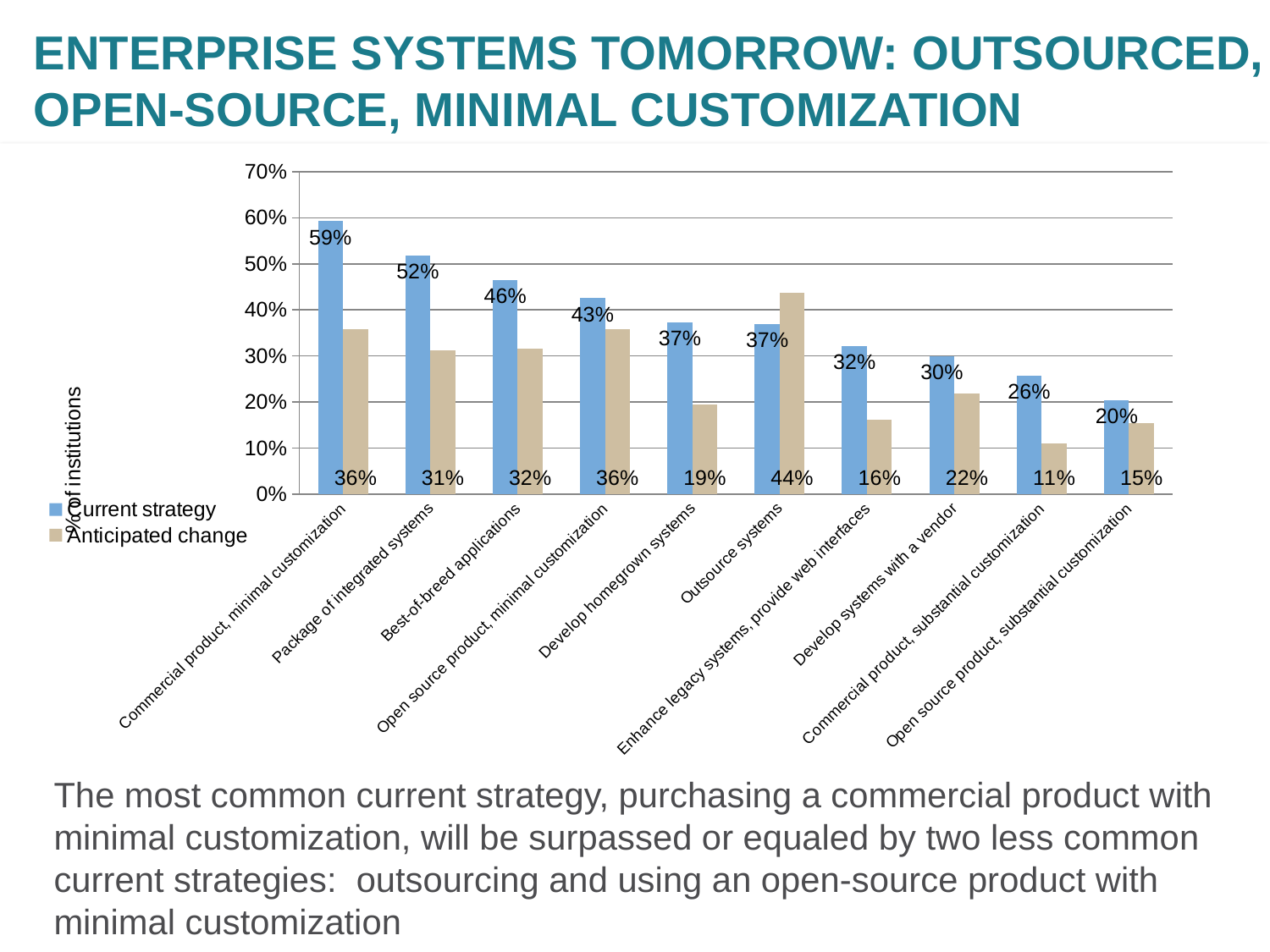
Which category has the highest Current strategy value? Commercial product, minimal customization What is the difference between the Current strategy and Anticipated change values for Develop homegrown systems? 18% How many categories are shown on the x axis? 10 Which category has the lowest Anticipated change value? Commercial product, substantial customization What is the Anticipated change value for Outsource systems? 44% What is the Anticipated change value for Commercial product, substantial customization? 11% What is the Current strategy value for Package of integrated systems? 52% How many series does the legend list? 2 For Outsource systems, which is larger: the Current strategy value or the Anticipated change value? Anticipated change What kind of chart is shown on the slide? Bar chart What is the Current strategy value for Outsource systems? 37% Do the Current strategy values rise or fall from left to right along the x axis? Fall